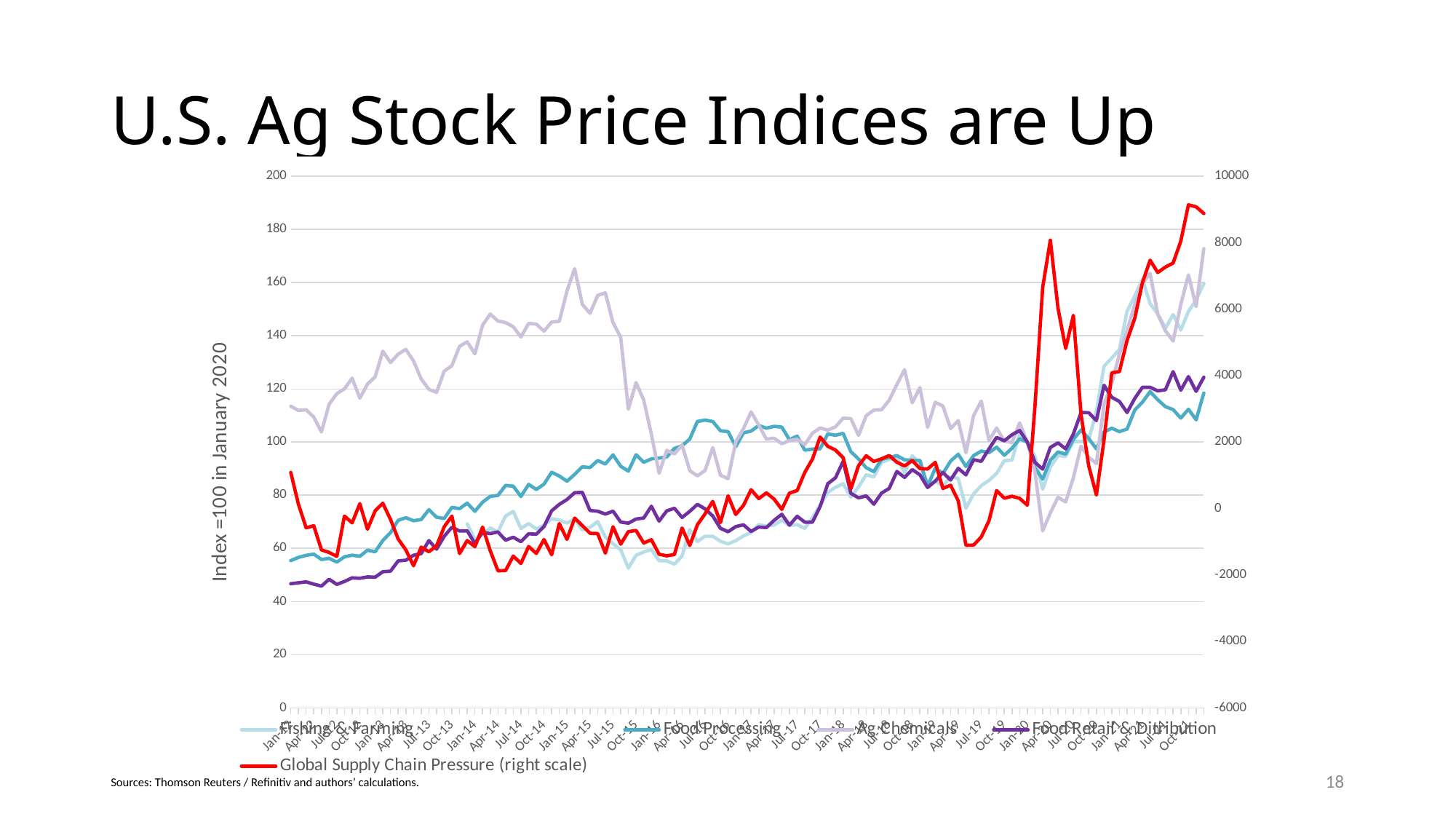
Does the Food Retail & Distribution series rise or fall overall from the start to the end of the period? Rise Is the value for Food Processing at the start of the series (Jan-12) greater or less than 60? less At the start of the series (Jan-12), which is higher: Ag Chemicals or Food Processing? Ag Chemicals Is the value for Ag Chemicals at the start of the series (Jan-12) greater or less than 100? greater At the end of the series, which is higher: Ag Chemicals or Food Retail & Distribution? Ag Chemicals What is the title of the chart on the slide? U.S. Ag Stock Price Indices are Up Is the value for Global Supply Chain Pressure at the end of the series greater or less than 8000 on the right scale? greater Which series is plotted on the right scale? Global Supply Chain Pressure What kind of chart is shown on the slide? Line chart How many series does the legend list? 5